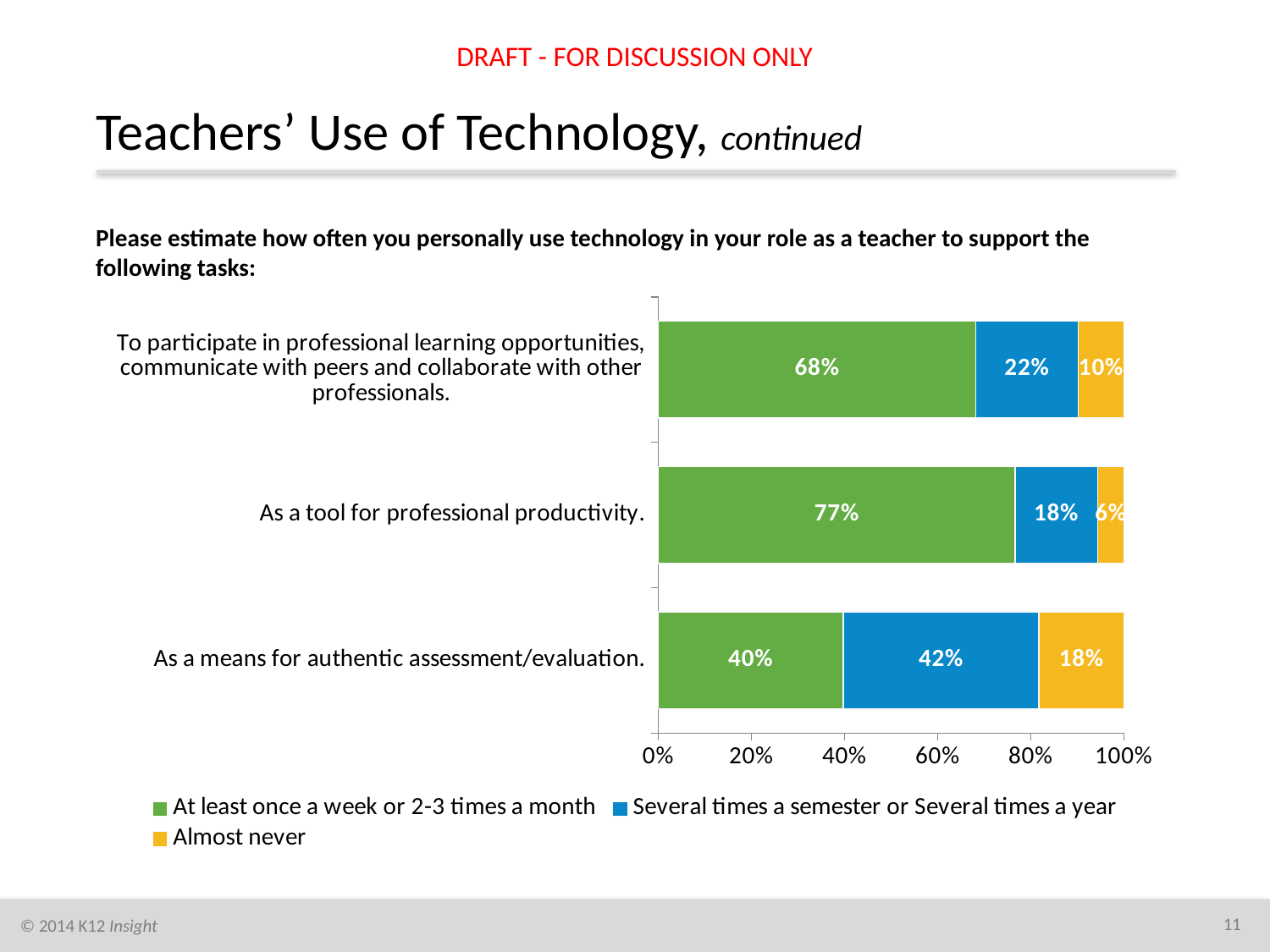
What percentage of teachers almost never use technology as a means for authentic assessment/evaluation? 18% Which task has the highest share of teachers using technology at least once a week or 2-3 times a month? As a tool for professional productivity. Which task has the lowest share of teachers using technology at least once a week or 2-3 times a month? As a means for authentic assessment/evaluation. What percentage of teachers use technology as a tool for professional productivity at least once a week or 2-3 times a month? 77% How many tasks (categories) are shown in the chart? 3 What percentage of teachers use technology to participate in professional learning opportunities several times a semester or several times a year? 22% What colour represents the 'Almost never' series in the chart? Yellow How many series does the legend list? 3 For authentic assessment/evaluation, which is larger: the 'At least once a week or 2-3 times a month' share or the 'Several times a semester or Several times a year' share? Several times a semester or Several times a year What is the difference between the 'At least once a week or 2-3 times a month' percentages for professional productivity and authentic assessment/evaluation? 37 percentage points What kind of chart is shown on the slide? Stacked bar chart What is the total of the three segments for the 'As a tool for professional productivity' bar? 101%